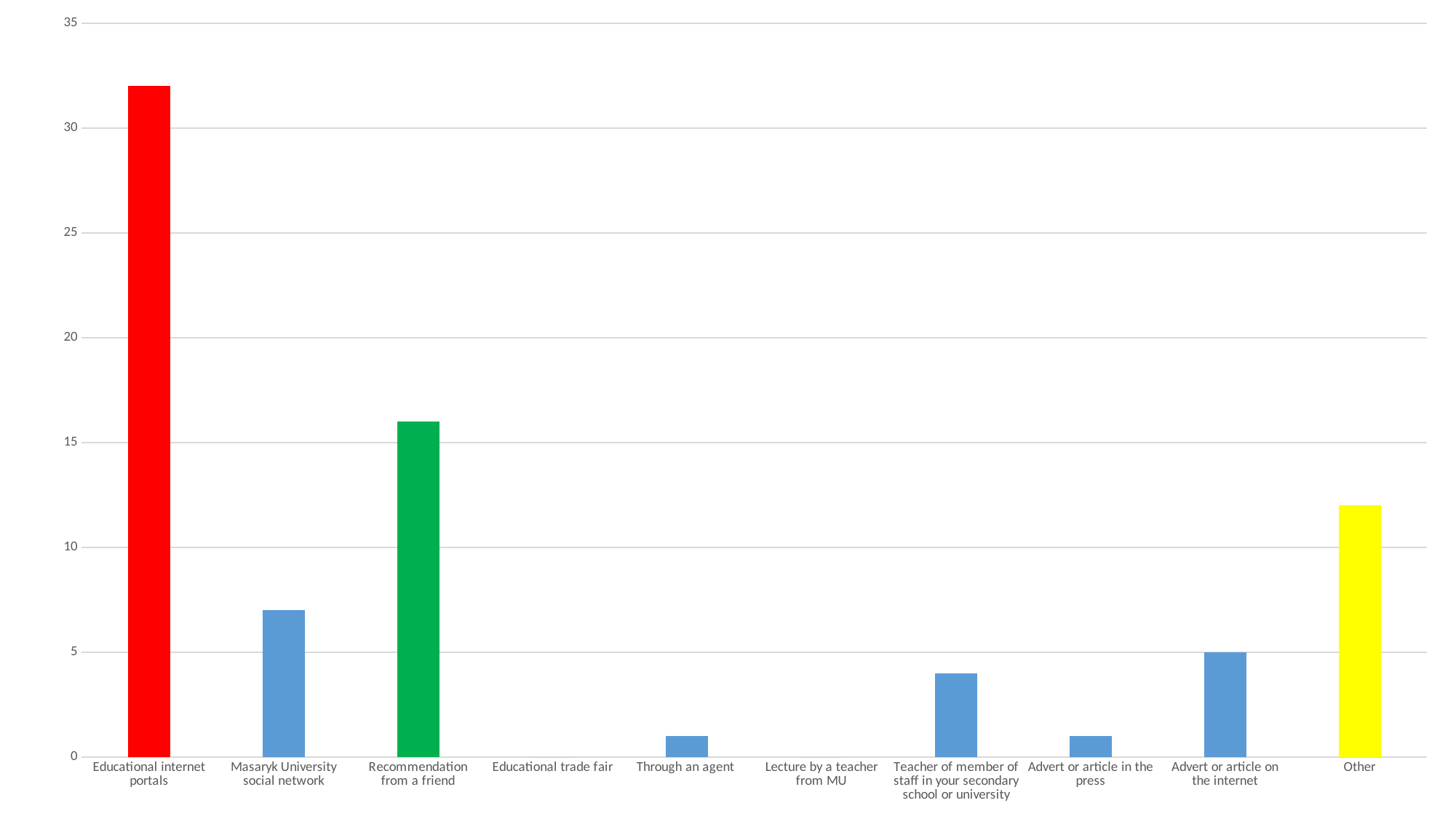
Is the value for Masaryk University social network greater or less than 5? greater Is the value for Other greater or less than 10? greater Which is larger, the value for Masaryk University social network or the value for Advert or article in the press? Masaryk University social network Is the value for Recommendation from a friend greater or less than 15? greater What colour is the bar for Educational internet portals? red Which category has the highest value in the chart? Educational internet portals What is the value for Advert or article on the internet? 5 What kind of chart is shown on the slide? bar chart Which is larger, the value for Recommendation from a friend or the value for Other? Recommendation from a friend How many categories are shown on the x axis of the chart? 10